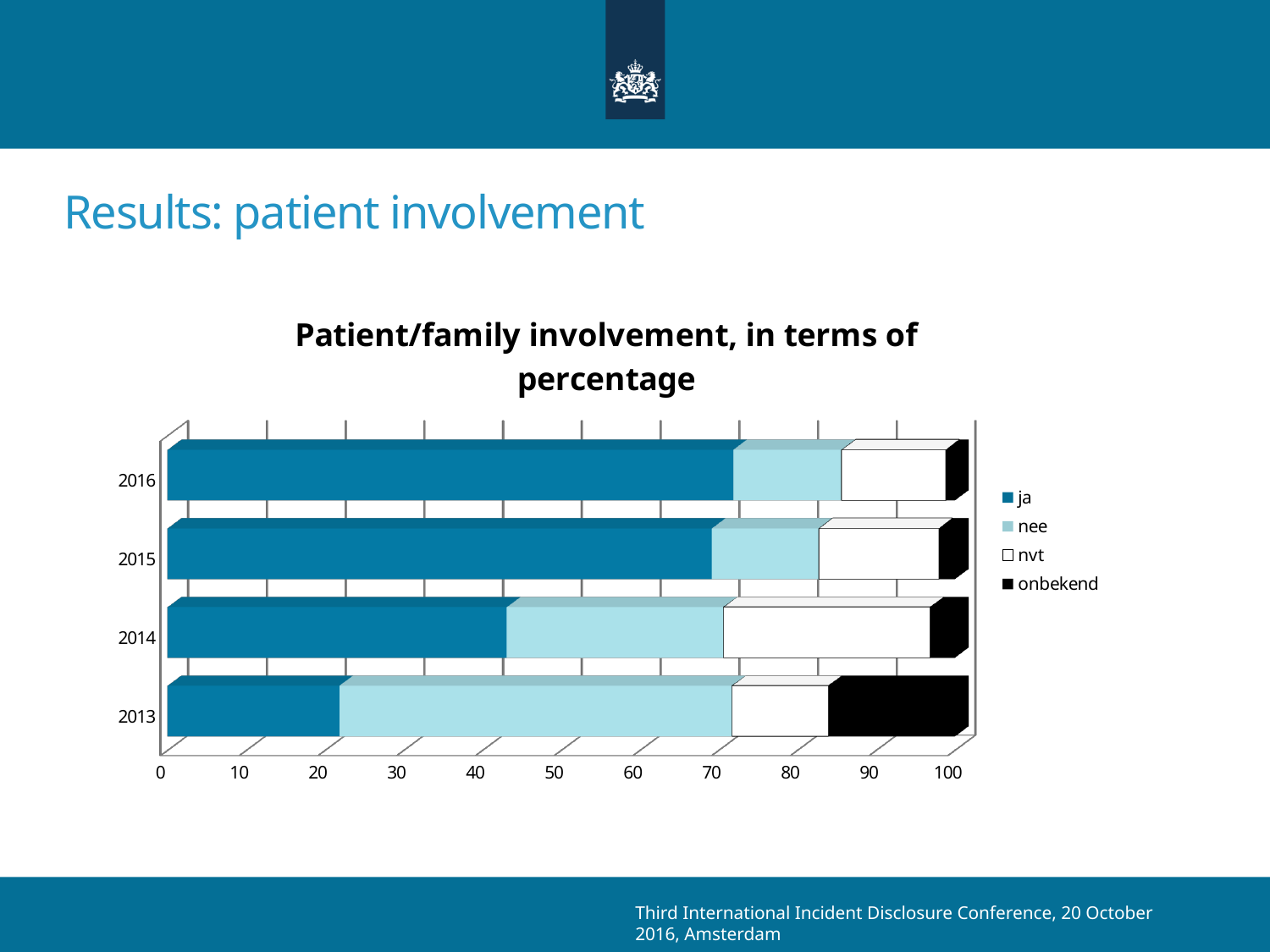
What is the title of the chart? Patient/family involvement, in terms of percentage Which year has the smallest 'ja' segment? 2013 Which year has the largest 'onbekend' segment? 2013 Is the 'ja' value for 2014 greater or less than 50? less Does the 'ja' share rise or fall from 2013 to 2016? rise How many series does the legend list? 4 Is the 'ja' value for 2013 greater or less than 30? less Which series is shown in black in the legend? onbekend Which year has the largest 'nee' segment? 2013 Is the 'ja' segment larger for 2014 or for 2013? 2014 What kind of chart is shown on the slide? stacked bar chart How many years are shown on the chart? 4